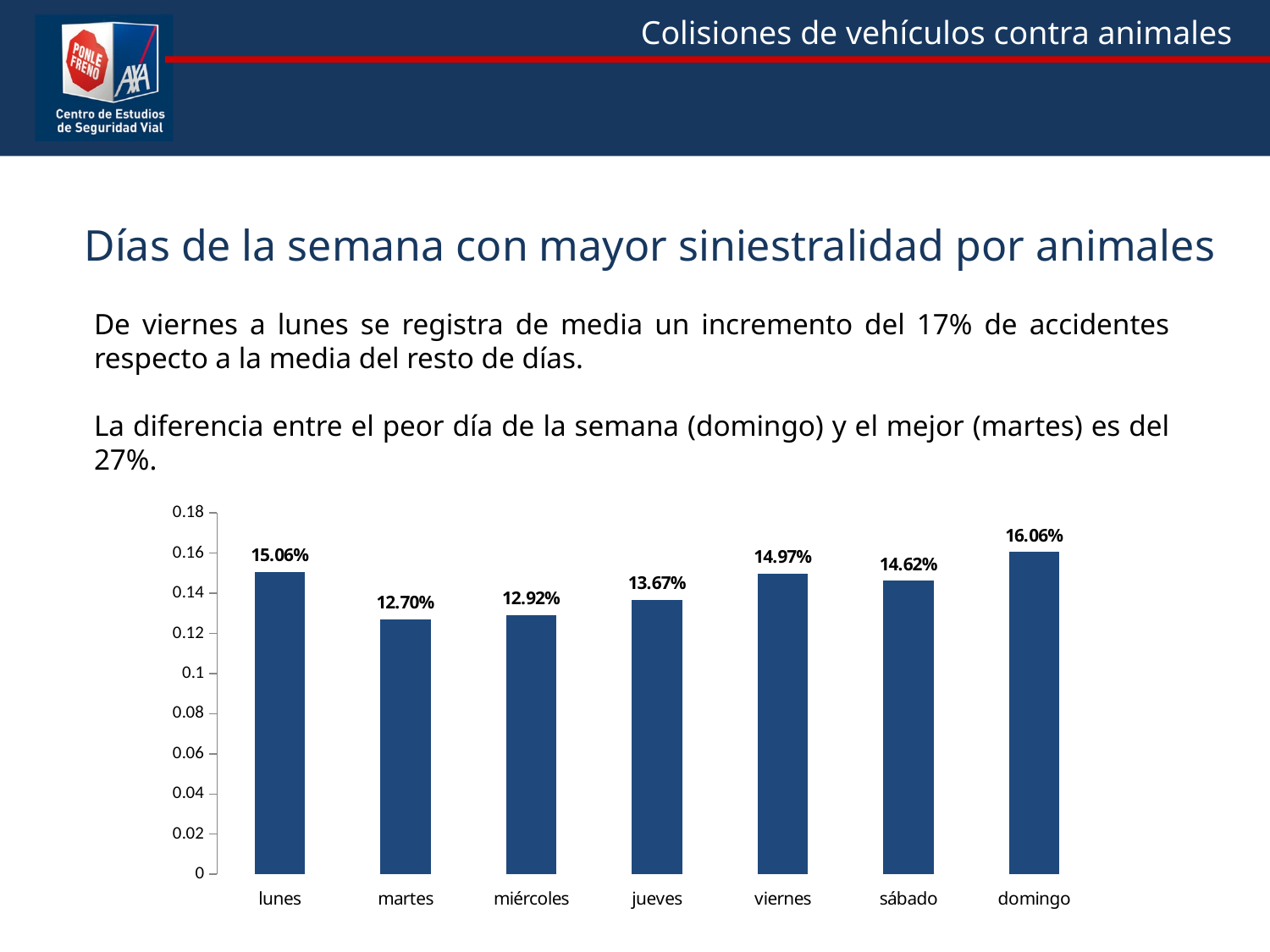
What is the highest tick value shown on the y axis? 0.18 Which day has the lowest value? martes How many days are shown on the x axis? 7 Which day has the highest value? domingo What is the difference between the values for lunes and miércoles? 2.14% What is the difference between the values for domingo and martes? 3.36% What kind of chart is shown on the slide? bar chart Which is larger, the value for viernes or the value for sábado? viernes Is the value for jueves greater or less than 0.14? less What is the value for martes? 12.70% What is the value for jueves? 13.67% What is the value for domingo? 16.06%